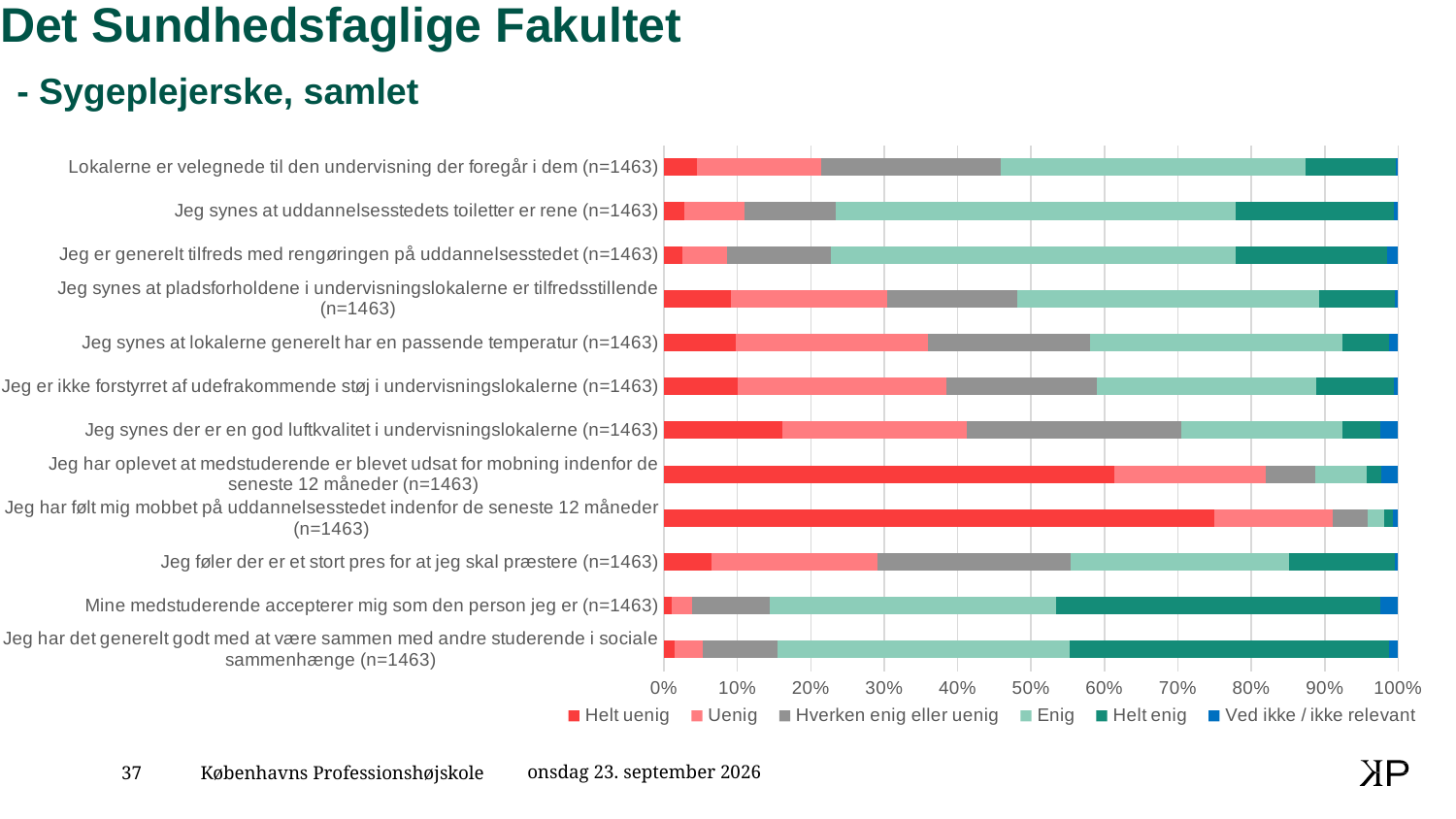
What is the first entry in the chart's legend? Helt uenig How many statements (categories) are plotted in the chart? 12 What sample size (n) is shown in the category labels of the chart? n=1463 Is the 'Helt uenig' share for 'Jeg har oplevet at medstuderende er blevet udsat for mobning indenfor de seneste 12 måneder' greater or less than 50%? greater How many series does the legend list? 6 Is the 'Helt uenig' share for 'Jeg synes der er en god luftkvalitet i undervisningslokalerne' greater or less than 10%? greater Which statement has the largest 'Helt uenig' share? Jeg har følt mig mobbet på uddannelsesstedet indenfor de seneste 12 måneder (n=1463) Which has the larger 'Helt uenig' share: 'Jeg synes der er en god luftkvalitet i undervisningslokalerne' or 'Jeg synes at lokalerne generelt har en passende temperatur'? Jeg synes der er en god luftkvalitet i undervisningslokalerne Is the 'Helt uenig' share for 'Jeg har følt mig mobbet på uddannelsesstedet indenfor de seneste 12 måneder' greater or less than 70%? greater Which has the larger 'Helt enig' share: 'Mine medstuderende accepterer mig som den person jeg er' or 'Lokalerne er velegnede til den undervisning der foregår i dem'? Mine medstuderende accepterer mig som den person jeg er What kind of chart is shown on the slide? Stacked bar chart